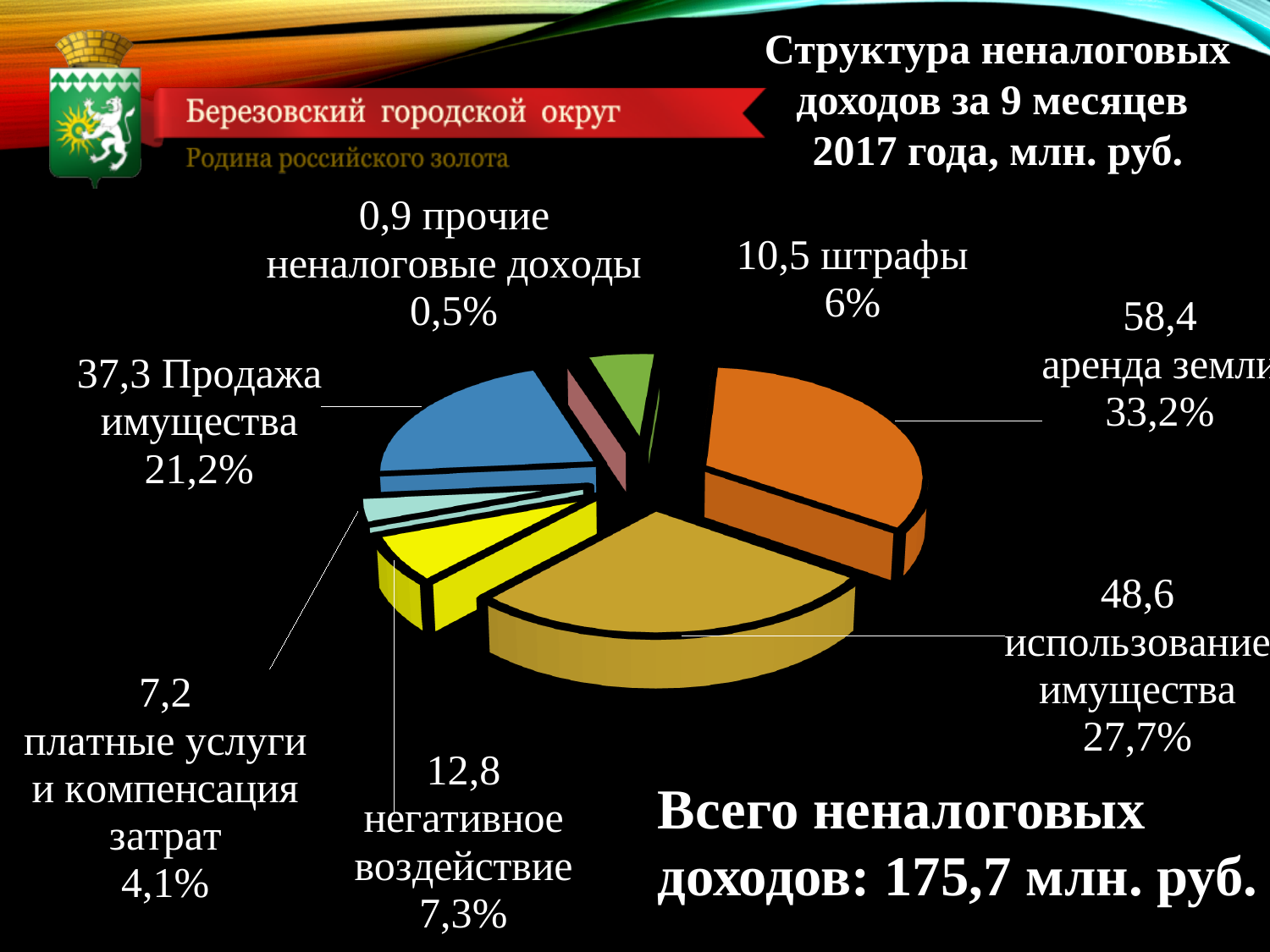
What kind of chart is shown on the slide? pie chart Which category has the smallest share of the pie? прочие неналоговые доходы What share of the pie does использование имущества have? 27,7% What is the difference between the values for аренда земли and использование имущества, in млн. руб.? 9,8 Which category has the largest share of the pie? аренда земли What is the title of the chart? Структура неналоговых доходов за 9 месяцев 2017 года, млн. руб. What is the value for штрафы, in млн. руб.? 10,5 What is the total of non-tax revenues stated on the slide? 175,7 млн. руб. What is the value for аренда земли, in млн. руб.? 58,4 How many categories does the pie chart show? 7 What share of the pie does Продажа имущества have? 21,2% Which is larger: негативное воздействие or платные услуги и компенсация затрат? негативное воздействие